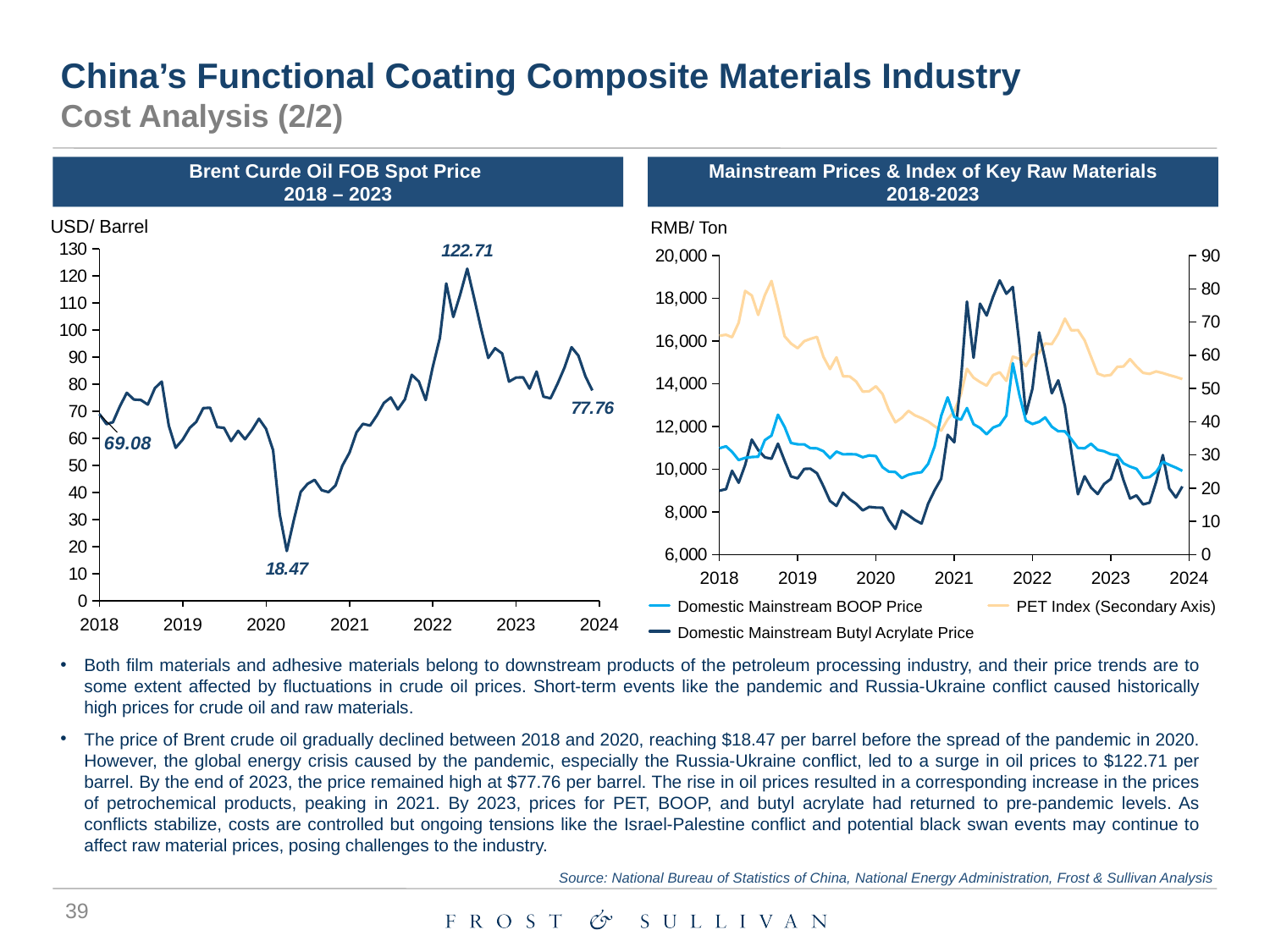
In the Brent Curde Oil FOB Spot Price chart, what value is labelled at the end of the series near 2024? 77.76 In the Brent Curde Oil FOB Spot Price chart, what is the lowest value labelled on the line? 18.47 How many series does the legend of the Mainstream Prices & Index of Key Raw Materials chart list? 3 In the Brent Curde Oil FOB Spot Price chart, what value is labelled at the start of the series in 2018? 69.08 In the Mainstream Prices & Index of Key Raw Materials chart, is the Domestic Mainstream BOOP Price at the start of 2018 greater or less than 12,000? less What unit is shown on the y axis of the Brent Curde Oil FOB Spot Price chart? USD/ Barrel In the Brent Curde Oil FOB Spot Price chart, which is larger: the labelled starting value 69.08 or the labelled ending value 77.76? 77.76 What type of chart is the Brent Curde Oil FOB Spot Price chart? Line chart In the Brent Curde Oil FOB Spot Price chart, what is the difference between the labelled peak value and the labelled lowest value? 104.24 In the Brent Curde Oil FOB Spot Price chart, what is the peak value labelled on the line? 122.71 In the Mainstream Prices & Index of Key Raw Materials chart, which series is plotted on the secondary axis? PET Index In the Mainstream Prices & Index of Key Raw Materials chart, is the Domestic Mainstream Butyl Acrylate Price at its 2021 peak greater or less than 16,000? greater